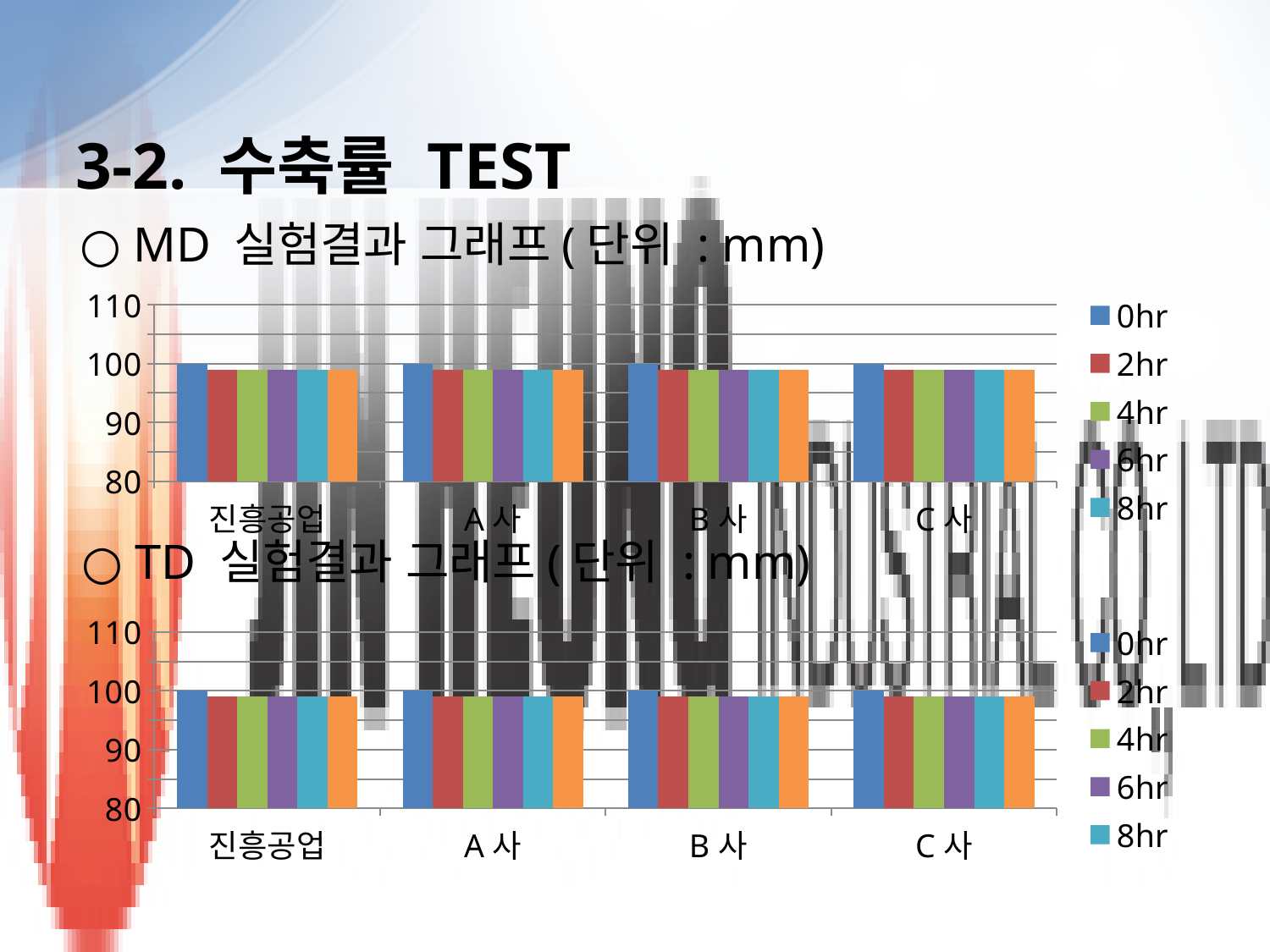
In the TD 실험결과 그래프, what is the value of the 0hr bar for C 사? 100 What is the first category on the x axis of the MD 실험결과 그래프? 진흥공업 What is the highest value shown on the y axis of the TD 실험결과 그래프? 110 In the TD 실험결과 그래프, is the 8hr value for B 사 greater or less than 110? less In the MD 실험결과 그래프, what is the value of the 0hr bar for 진흥공업? 100 How many categories are shown on the x axis of the TD 실험결과 그래프? 4 What unit is given in the title of the MD 실험결과 그래프? mm In the MD 실험결과 그래프, is the 4hr value for 진흥공업 greater or less than 80? greater What kind of chart is the MD 실험결과 그래프? bar chart In the MD 실험결과 그래프, is the 2hr value for A 사 greater or less than 90? greater